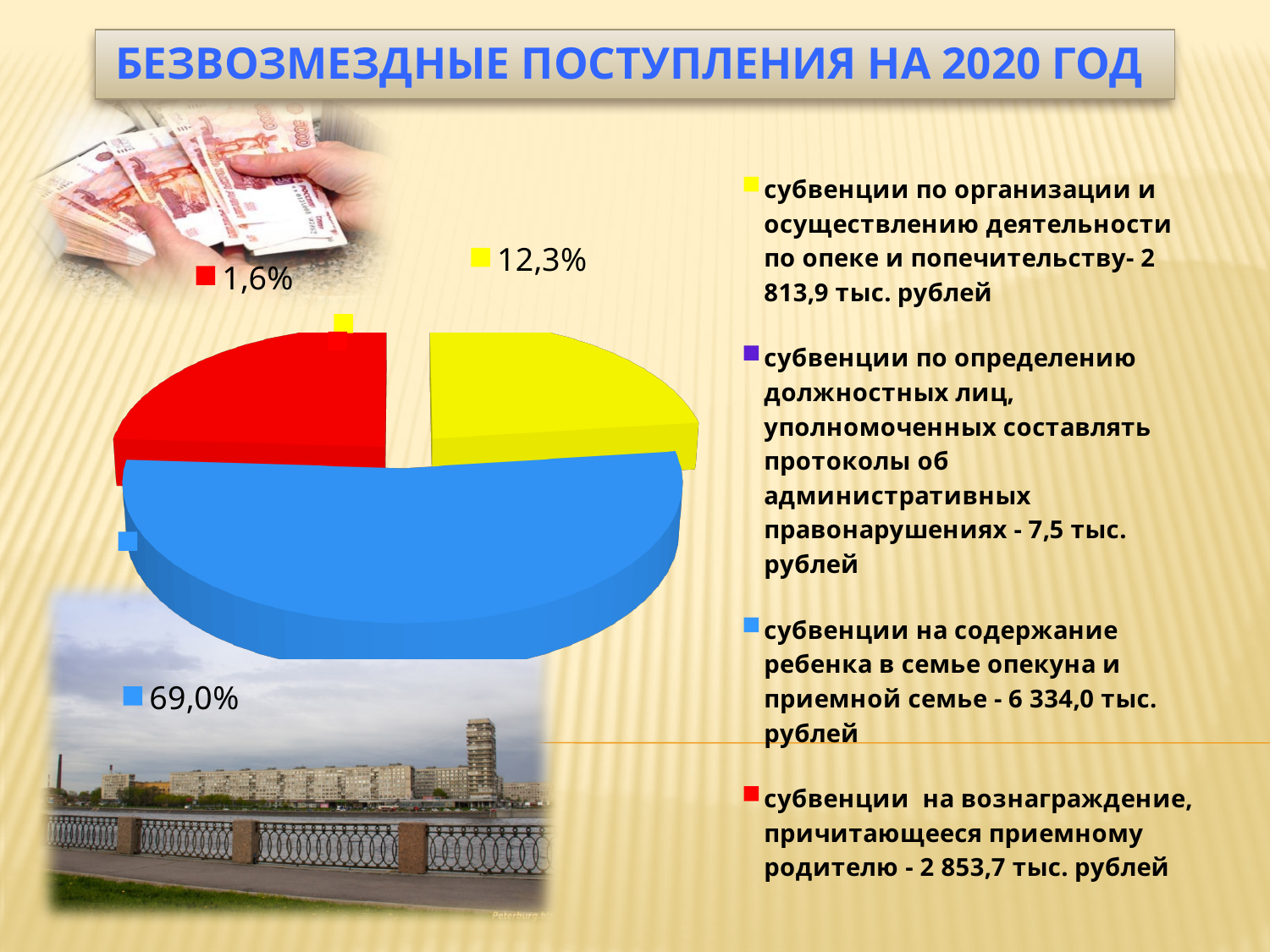
How many categories does the legend of the pie chart list? 4 According to the legend, what amount is given for субвенции по определению должностных лиц, уполномоченных составлять протоколы об административных правонарушениях? 7,5 тыс. рублей What percentage label is shown for the blue slice of the pie chart? 69,0% What is the title of the slide containing the pie chart? БЕЗВОЗМЕЗДНЫЕ ПОСТУПЛЕНИЯ НА 2020 ГОД Which category has the largest slice of the pie chart? субвенции на содержание ребенка в семье опекуна и приемной семье What percentage label is shown with the yellow marker on the pie chart? 12,3% What colour is the largest slice of the pie chart? blue According to the legend, what amount is given for субвенции по организации и осуществлению деятельности по опеке и попечительству? 2 813,9 тыс. рублей What percentage label is shown with the red marker on the pie chart? 1,6% Which amount is larger in the legend: субвенции по опеке и попечительству (2 813,9 тыс. рублей) or субвенции на вознаграждение приемному родителю (2 853,7 тыс. рублей)? субвенции на вознаграждение приемному родителю What type of chart is shown on the slide? pie chart According to the legend, what amount is given for субвенции на содержание ребенка в семье опекуна и приемной семье? 6 334,0 тыс. рублей